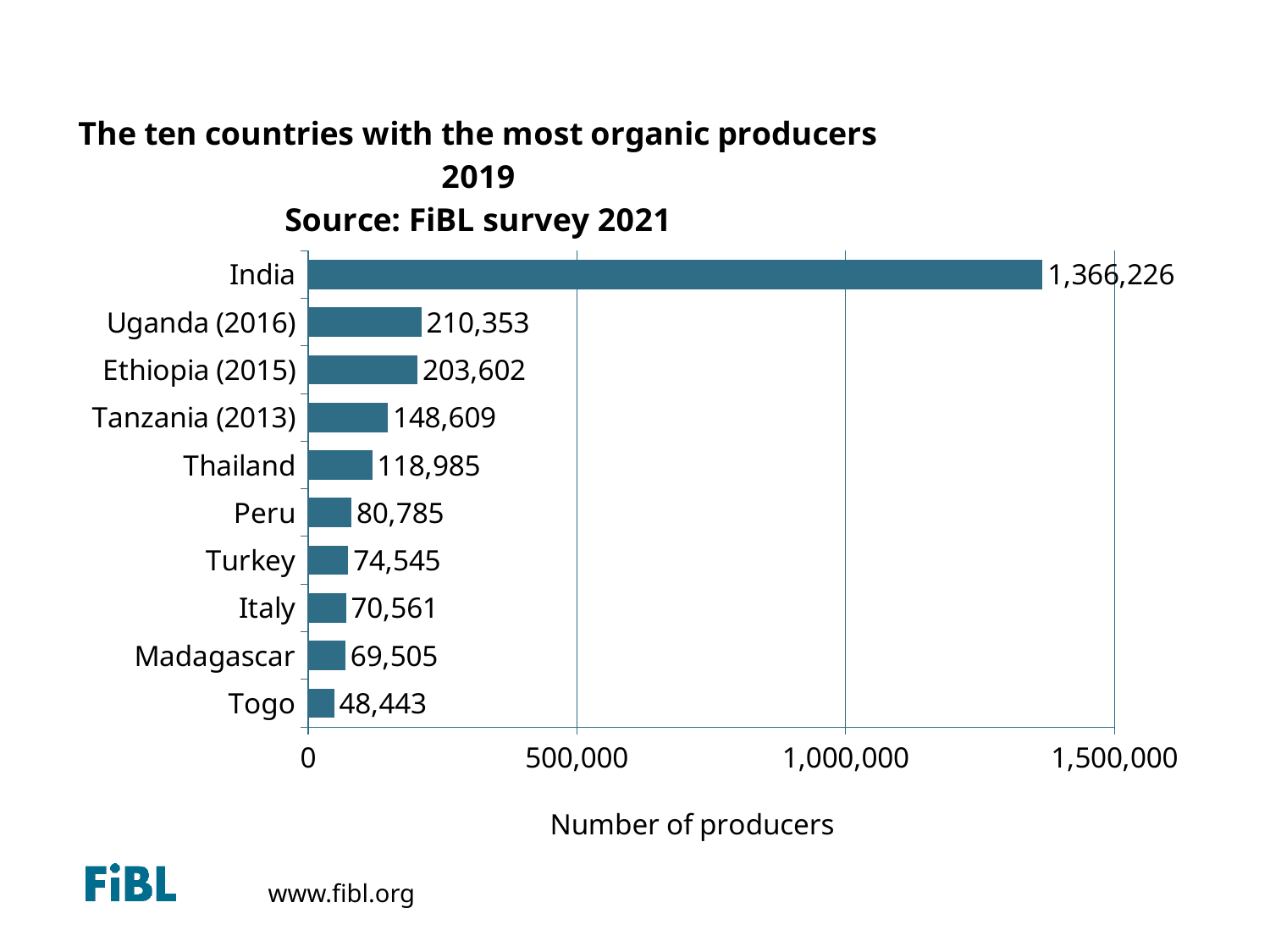
What is the difference in number of producers between India and Togo? 1,317,783 How many organic producers does India have according to the chart? 1,366,226 What is the label of the horizontal axis? Number of producers Which country has the fewest organic producers in the chart? Togo What is the difference in number of producers between Uganda (2016) and Ethiopia (2015)? 6,751 Is the value for Tanzania (2013) greater or less than 500,000? less What value is shown for Madagascar? 69,505 Which country has the most organic producers in the chart? India How many countries are shown in the chart? 10 What type of chart is shown on the slide? bar chart Which has more organic producers, Peru or Turkey? Peru What is the number of producers shown for Thailand? 118,985